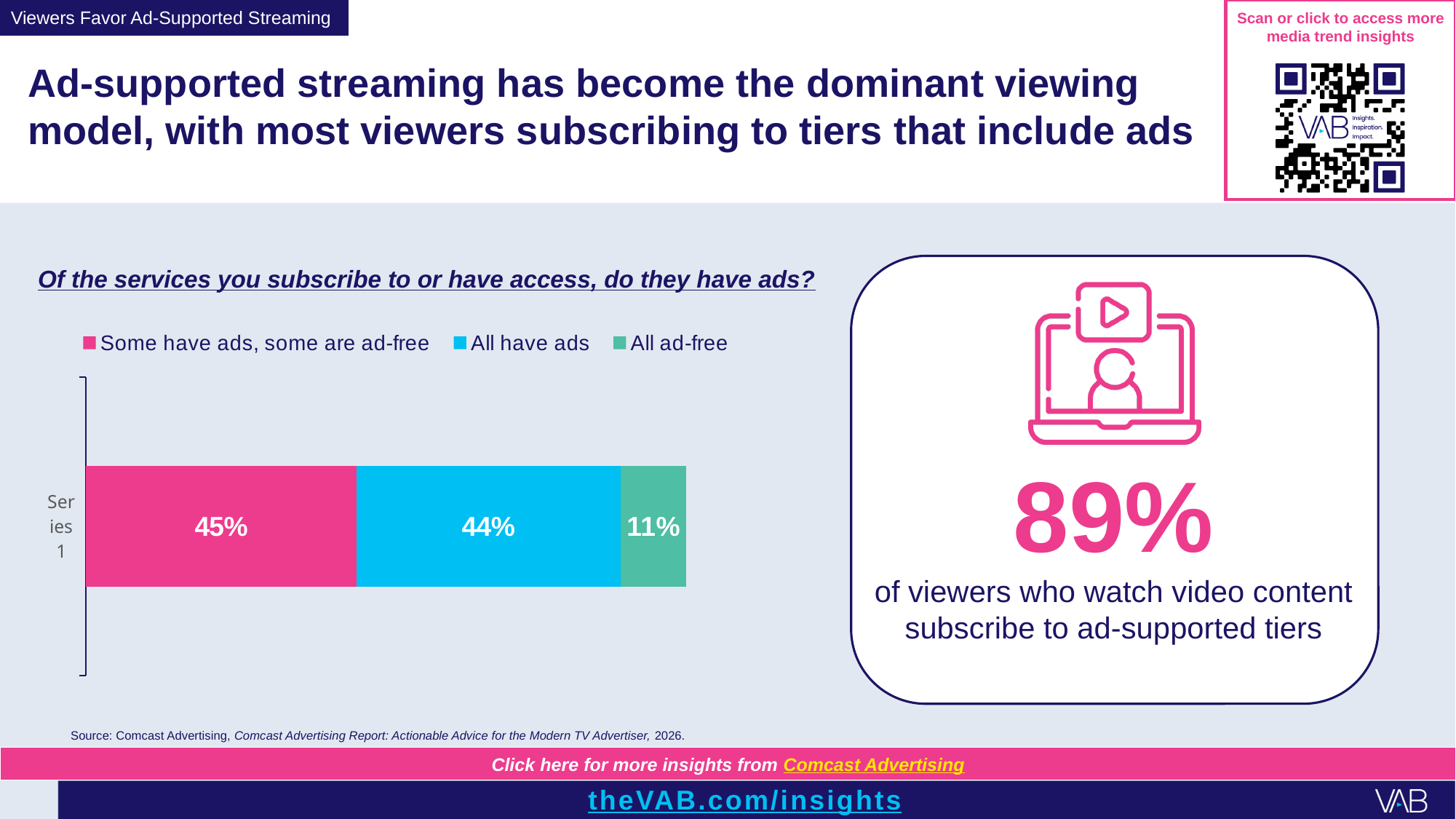
What percentage of respondents said all of their services have ads? 44% Which response has the smallest share in the bar? All ad-free What kind of chart is shown on the slide? Stacked bar chart Which is larger: the 'All have ads' share or the 'All ad-free' share? All have ads What percentage of respondents said some of their services have ads and some are ad-free? 45% What percentage of respondents said all of their services are ad-free? 11% What colour is the 'All have ads' segment in the chart? Blue What is the difference between the 'All have ads' share and the 'All ad-free' share? 33% What question is the chart titled with? Of the services you subscribe to or have access, do they have ads? What is the total of the three segments in the stacked bar? 100% Which response has the largest share in the bar? Some have ads, some are ad-free How many series does the legend list? 3